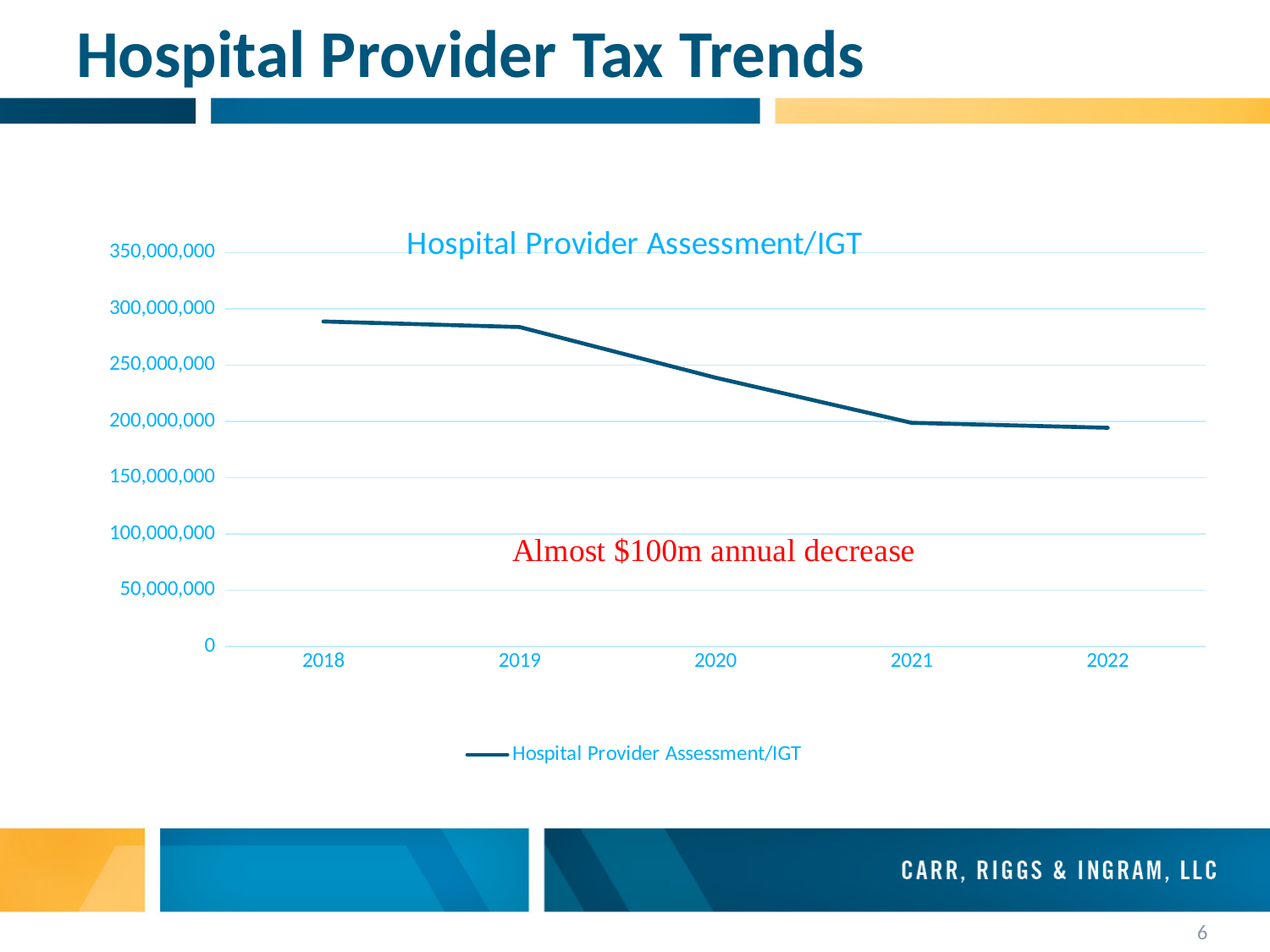
Do the values rise or fall from 2018 to 2022? fall How many years are plotted along the x axis? 5 What is the title of the chart? Hospital Provider Assessment/IGT Is the value for 2022 greater or less than 150,000,000? greater What kind of chart is shown on the slide? line chart Is the value for 2019 greater or less than 250,000,000? greater Is the value for 2018 greater or less than 250,000,000? greater Which is larger, the value for 2019 or the value for 2021? 2019 How many series does the legend list? 1 What does the red annotation on the chart say? Almost $100m annual decrease Which is larger, the value for 2018 or the value for 2020? 2018